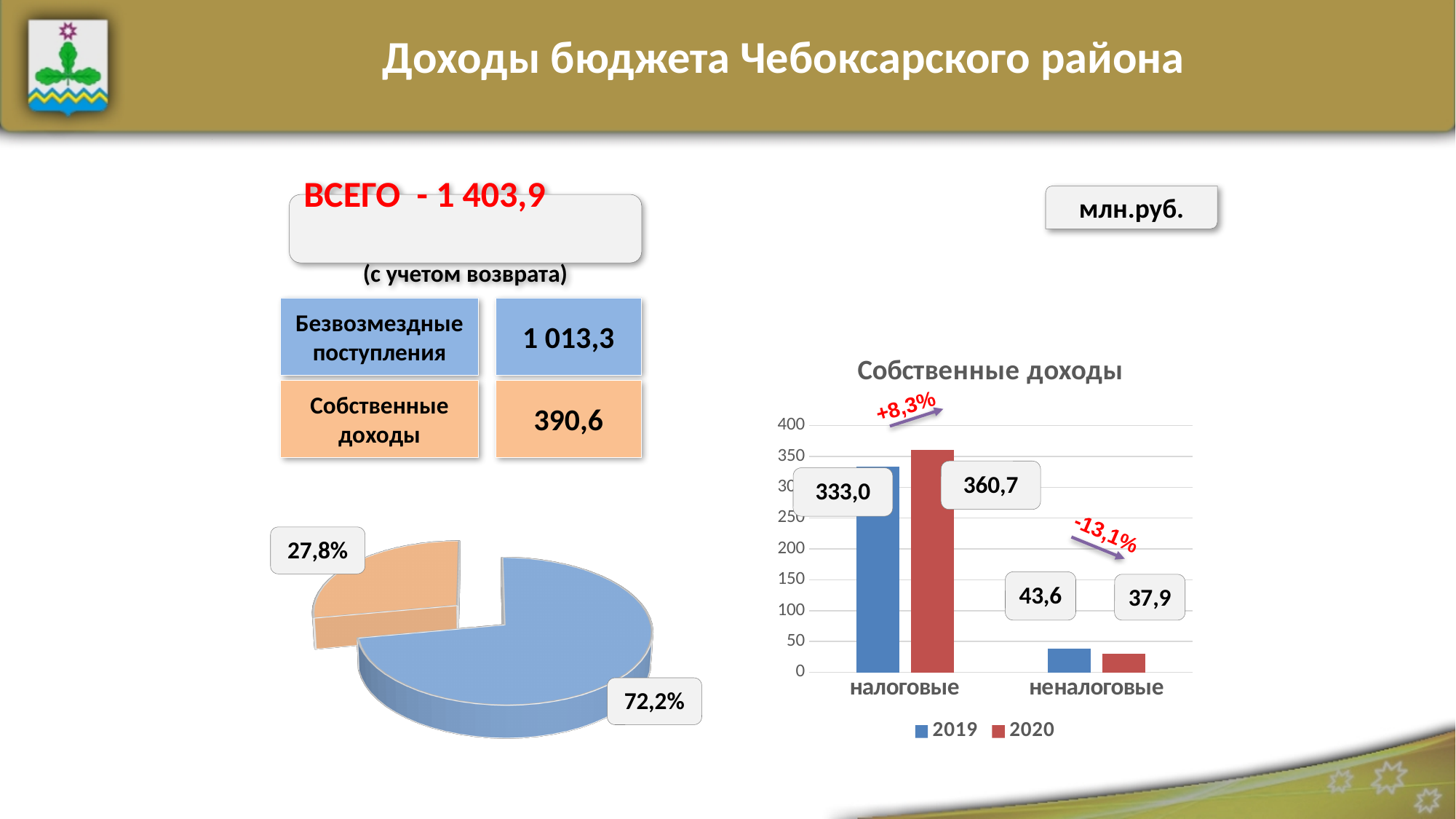
In the bar chart titled 'Собственные доходы', by how much did the value for налоговые change from 2019 to 2020? 27,7 In the bar chart titled 'Собственные доходы', which category has the highest value in 2020? налоговые How many series does the legend of the bar chart titled 'Собственные доходы' list? 2 What kind of chart is the chart titled 'Собственные доходы'? bar chart In the pie chart on the left of the slide, what is the share of the largest slice? 72,2% In the bar chart titled 'Собственные доходы', what is the value for налоговые in 2020? 360,7 In the bar chart titled 'Собственные доходы', what is the difference between the 2019 and 2020 values for неналоговые? 5,7 How many slices does the pie chart on the left of the slide have? 2 In the bar chart titled 'Собственные доходы', what is the value for неналоговые in 2020? 37,9 In the bar chart titled 'Собственные доходы', what is the value for неналоговые in 2019? 43,6 In the bar chart titled 'Собственные доходы', which is larger: неналоговые in 2019 or неналоговые in 2020? неналоговые in 2019 In the bar chart titled 'Собственные доходы', what is the value for налоговые in 2019? 333,0